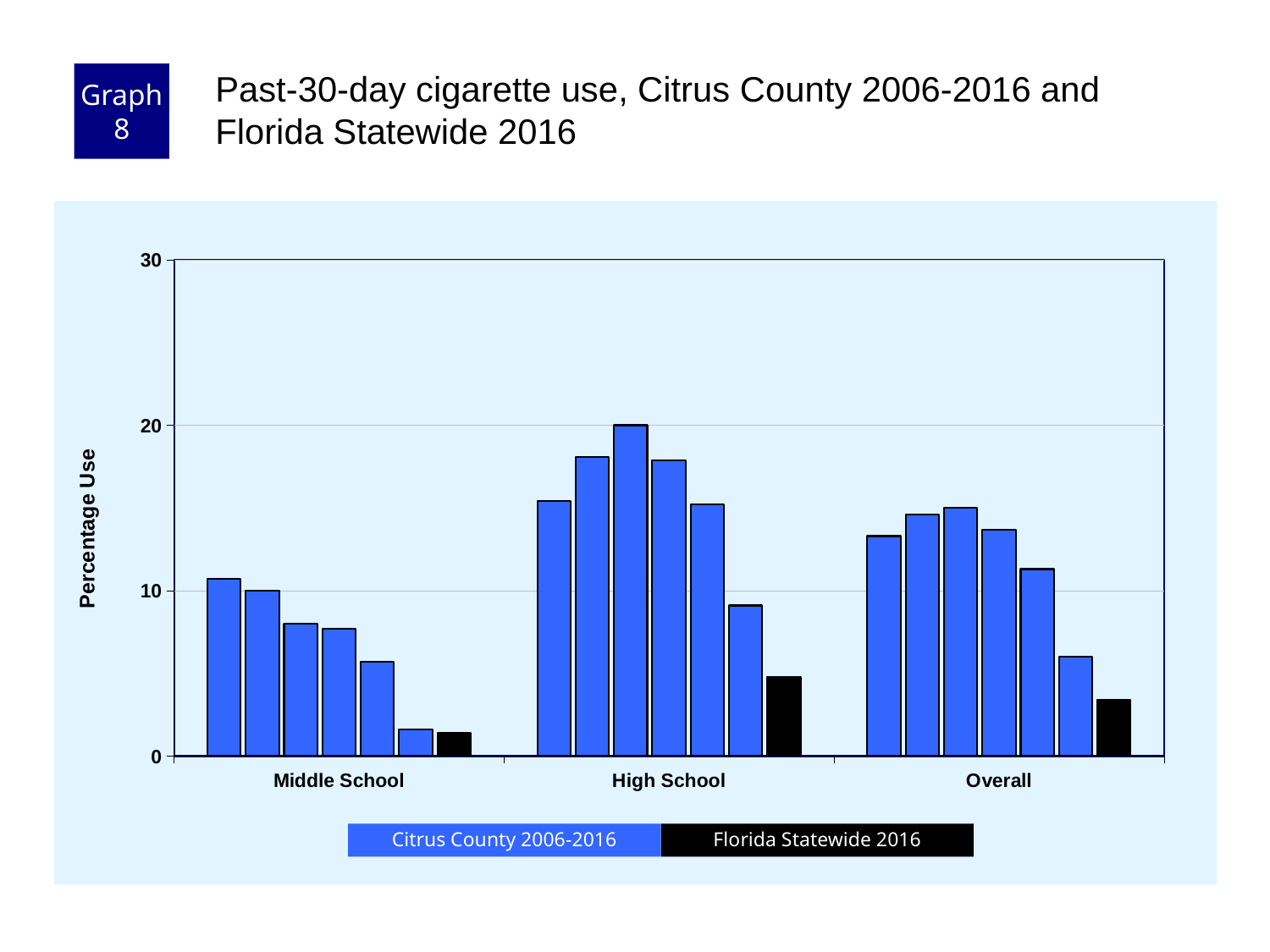
How many series does the legend list? 2 Which category has the highest Florida Statewide 2016 value? High School Which is larger, the Florida Statewide 2016 value for High School or for Overall? High School In the Middle School group, do the Citrus County 2006-2016 bars rise or fall from left to right? fall Which category has the lowest Florida Statewide 2016 value? Middle School Is the Florida Statewide 2016 value for High School greater or less than 10? less Is the Florida Statewide 2016 value for Overall greater or less than 10? less What colour represents Florida Statewide 2016 in the legend? black What kind of chart is shown on the slide? bar chart Is the tallest Citrus County 2006-2016 bar in the High School group greater or less than 10? greater What is the label on the y axis? Percentage Use How many categories are shown along the x axis? 3